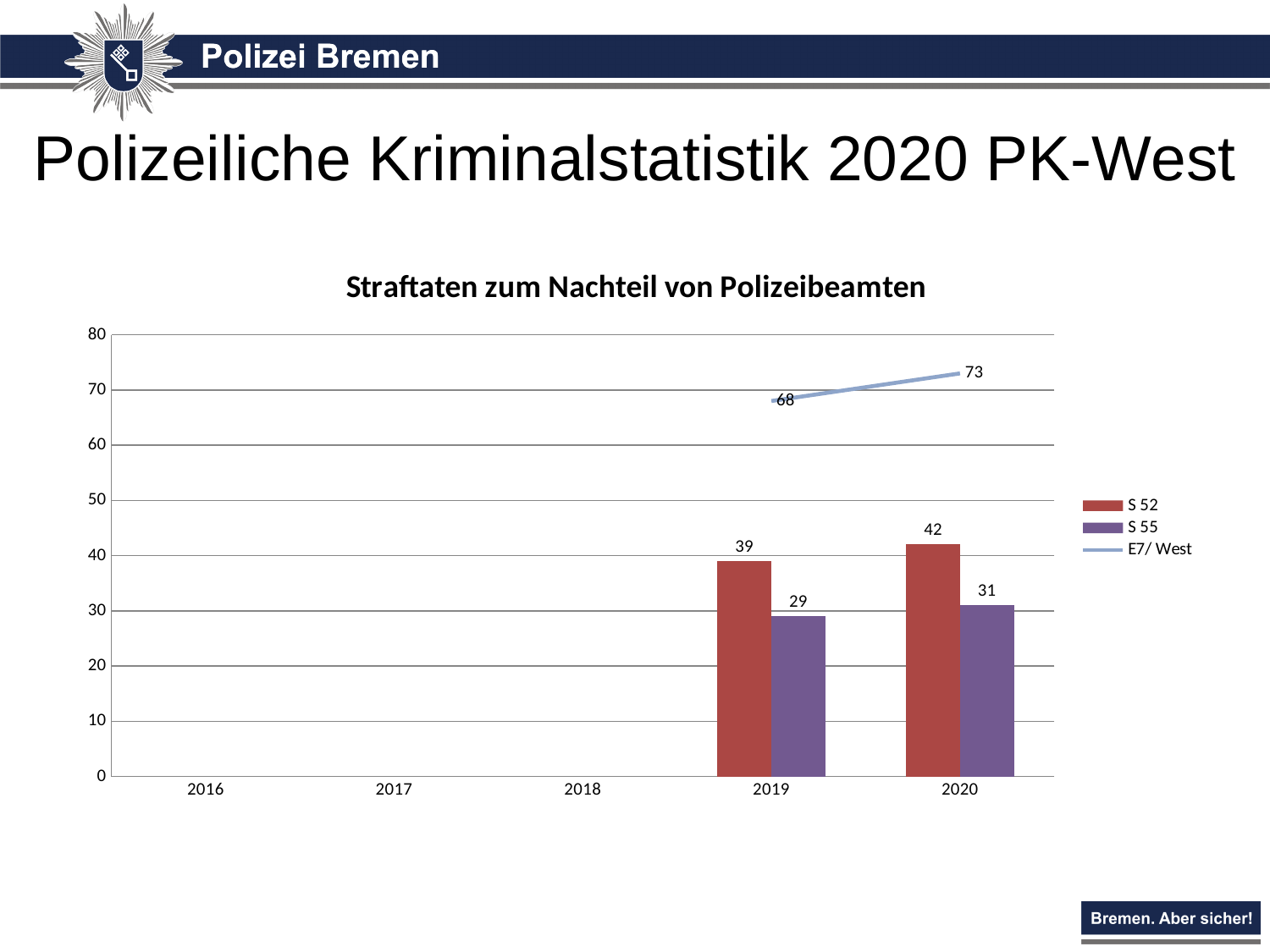
How many years are shown on the x axis? 5 Which is larger in 2020, S 52 or S 55? S 52 What is the value for S 52 in 2019? 39 What is the value for S 55 in 2020? 31 By how much did the E7/ West value change from 2019 to 2020? 5 What is the value for E7/ West in 2020? 73 What is the title of the chart? Straftaten zum Nachteil von Polizeibeamten In which year is the S 52 value highest? 2020 What is the value for E7/ West in 2019? 68 Does the E7/ West line rise or fall from 2019 to 2020? rise How many series does the legend list? 3 What is the difference between the S 52 and S 55 values in 2019? 10